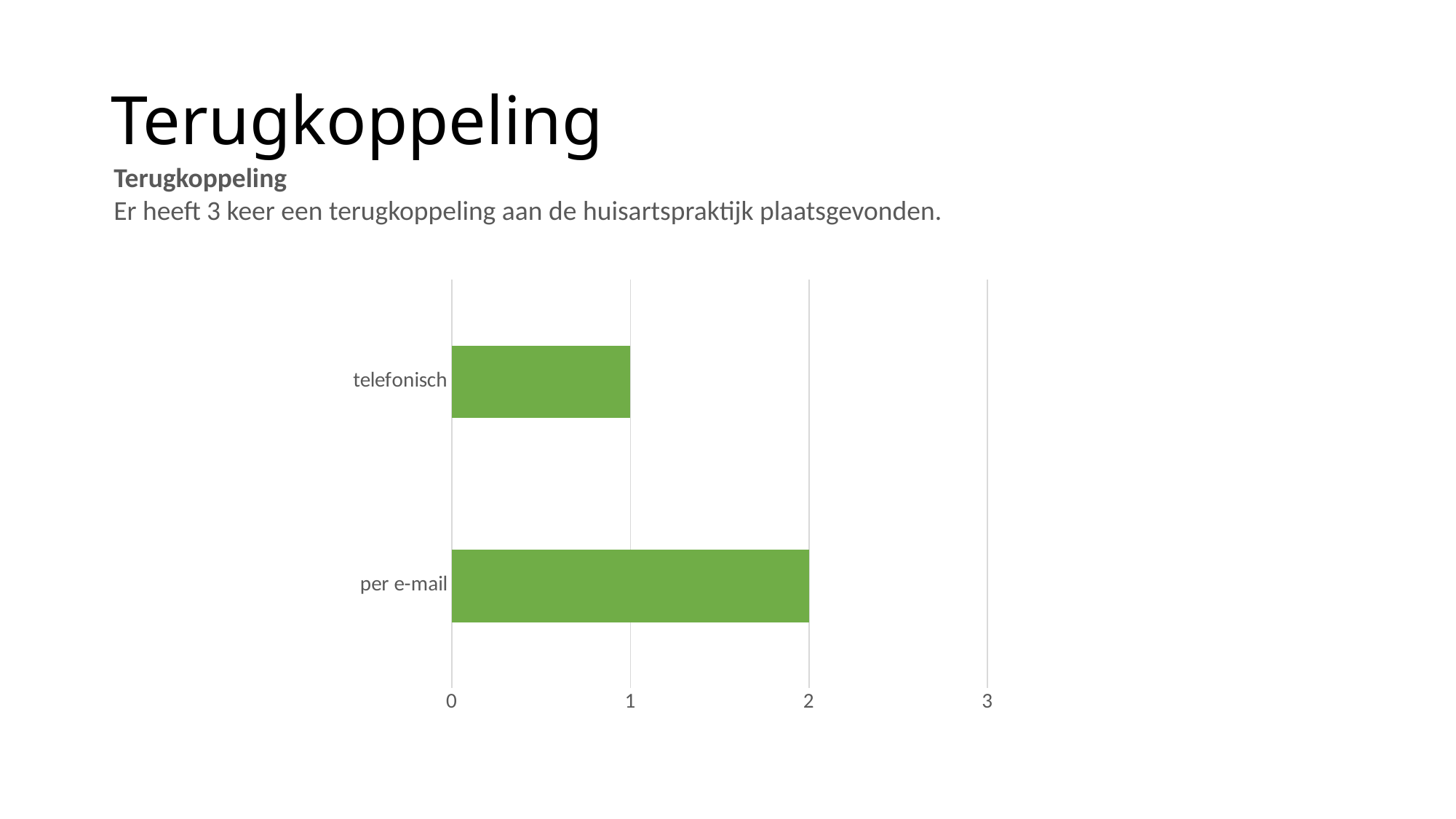
What is the value for telefonisch? 1 Which is larger, the value for telefonisch or the value for per e-mail? per e-mail How many categories are shown in the chart? 2 What kind of chart is shown on the slide? bar chart What is the difference between the values for per e-mail and telefonisch? 1 Which category has the lowest value? telefonisch What is the highest tick value shown on the value axis? 3 What colour are the bars in the chart? green What is the value for per e-mail? 2 Is the value for per e-mail greater or less than 3? less Which category has the highest value? per e-mail